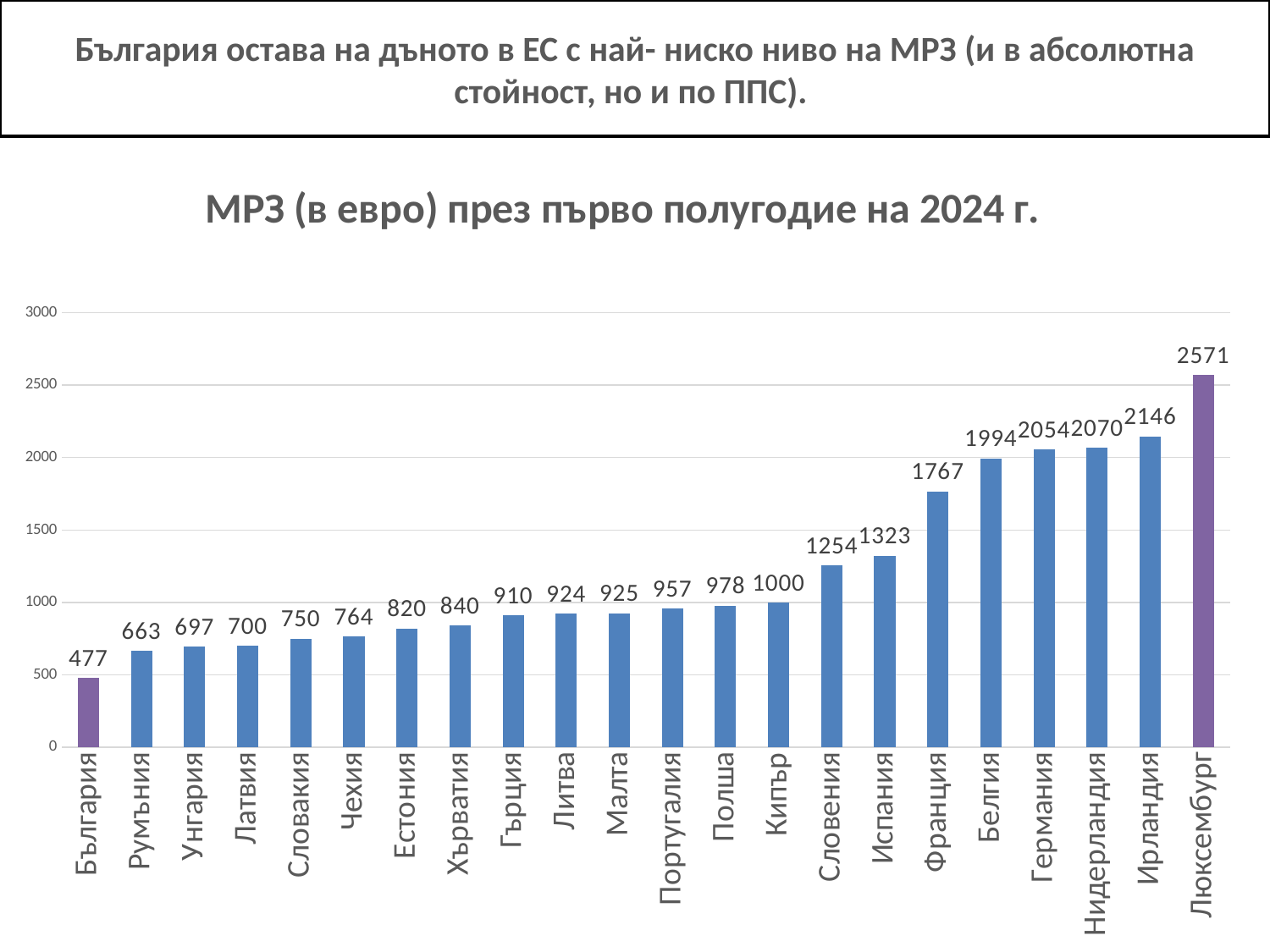
What is the difference between the values for Германия and Белгия? 60 What is the difference between the values for Люксембург and България? 2094 What is the minimum wage value shown for България? 477 Do the values rise or fall moving from left to right along the x axis? rise What is the value shown for Кипър? 1000 Which country has the lowest value in the chart? България Which has a larger value, Испания or Словения? Испания What is the value shown for Франция? 1767 Which country has the highest value in the chart? Люксембург What is the title of the chart? МРЗ (в евро) през първо полугодие на 2024 г. How many countries are shown in the chart? 22 What type of chart is shown on the slide? bar chart